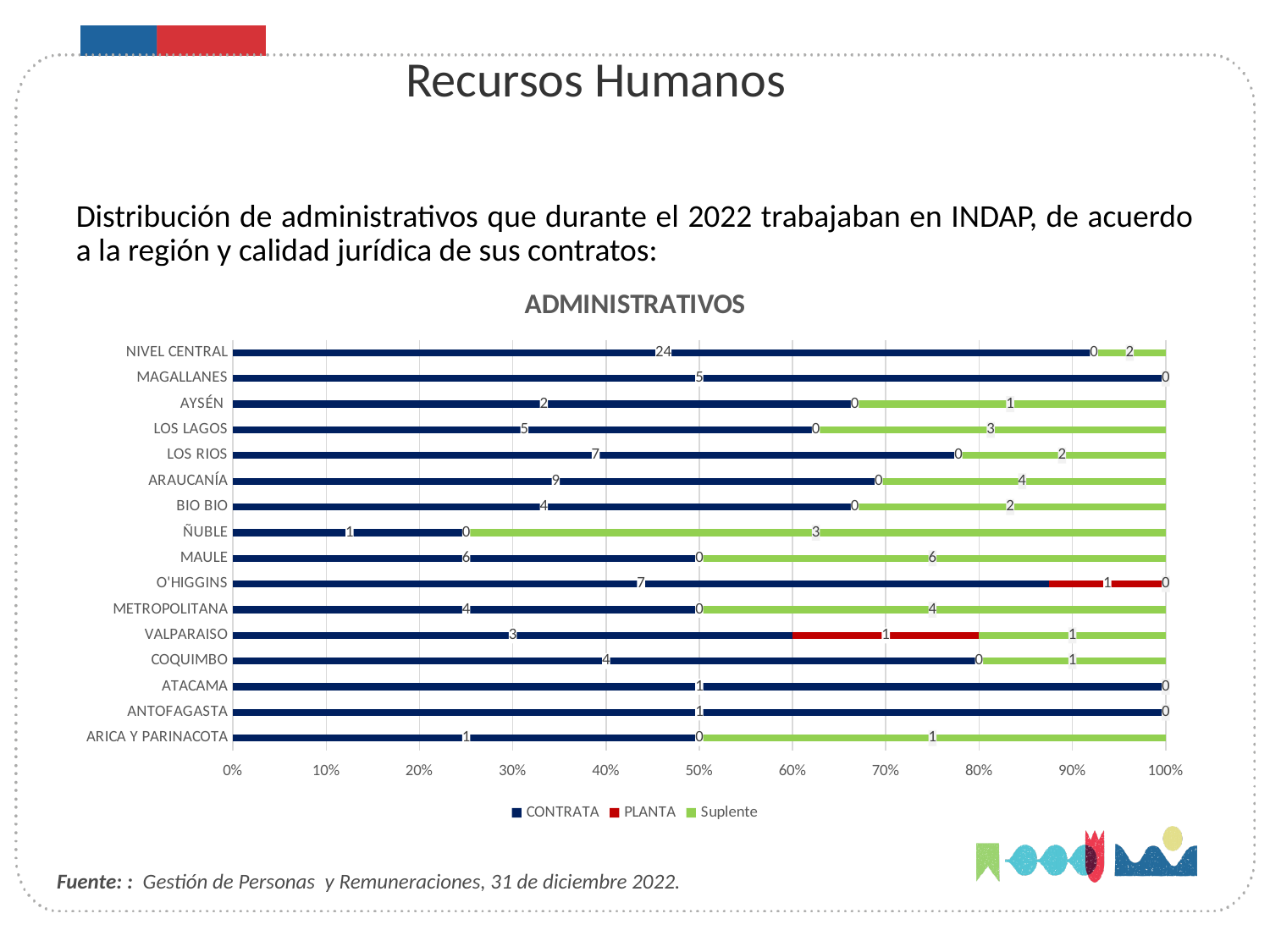
Which region has the highest CONTRATA value? NIVEL CENTRAL Which is larger, the CONTRATA value for LOS RIOS or the CONTRATA value for LOS LAGOS? LOS RIOS What is the total of the labeled values (CONTRATA, PLANTA and Suplente) for MAULE? 12 How many series does the legend list in the ADMINISTRATIVOS chart? 3 What is the CONTRATA value for NIVEL CENTRAL? 24 How many categories (regions) are shown on the vertical axis of the ADMINISTRATIVOS chart? 16 Which region has the highest Suplente value? MAULE What type of chart is shown on the slide? Bar chart What is the Suplente value for ARAUCANÍA? 4 What is the difference between the CONTRATA values for ARAUCANÍA and BIO BIO? 5 Which series is shown in red in the legend? PLANTA What is the PLANTA value for O'HIGGINS? 1